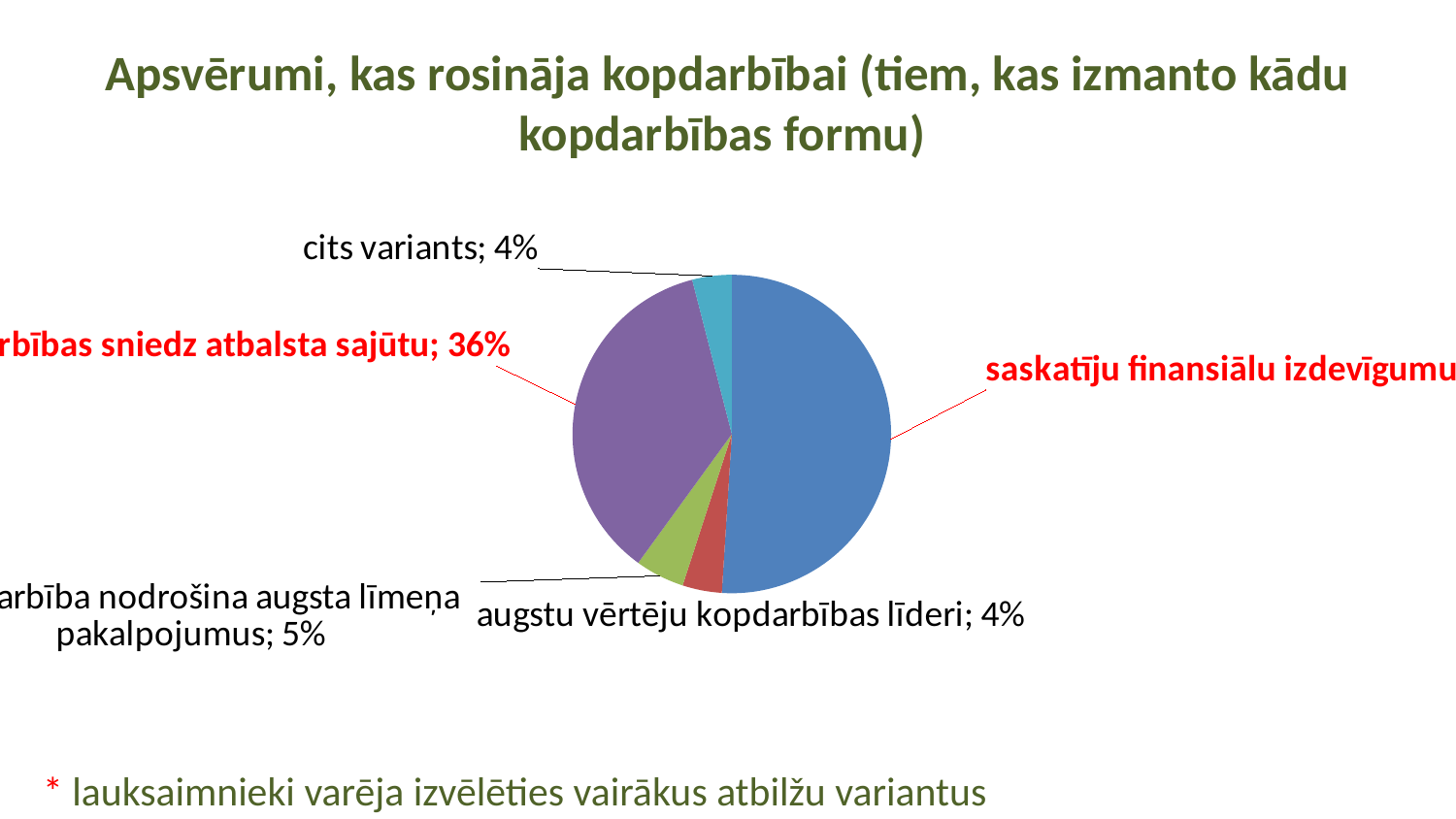
What is the title of the chart on the slide? Apsvērumi, kas rosināja kopdarbībai (tiem, kas izmanto kādu kopdarbības formu) Which slice of the pie chart is the largest? saskatīju finansiālu izdevīgumu How many slices does the pie chart have? 5 What kind of chart is shown on the slide? pie chart What share of the pie is labelled "cits variants"? 4% Which two slices share the smallest value in the pie chart? cits variants and augstu vērtēju kopdarbības līderi What is the difference in percentage points between "cits variants" and "augstu vērtēju kopdarbības līderi"? 0 Which is larger: the slice for "saskatīju finansiālu izdevīgumu" or the slice for "cits variants"? saskatīju finansiālu izdevīgumu What percentage is shown for "augstu vērtēju kopdarbības līderi"? 4% What colour is the slice for "saskatīju finansiālu izdevīgumu"? blue